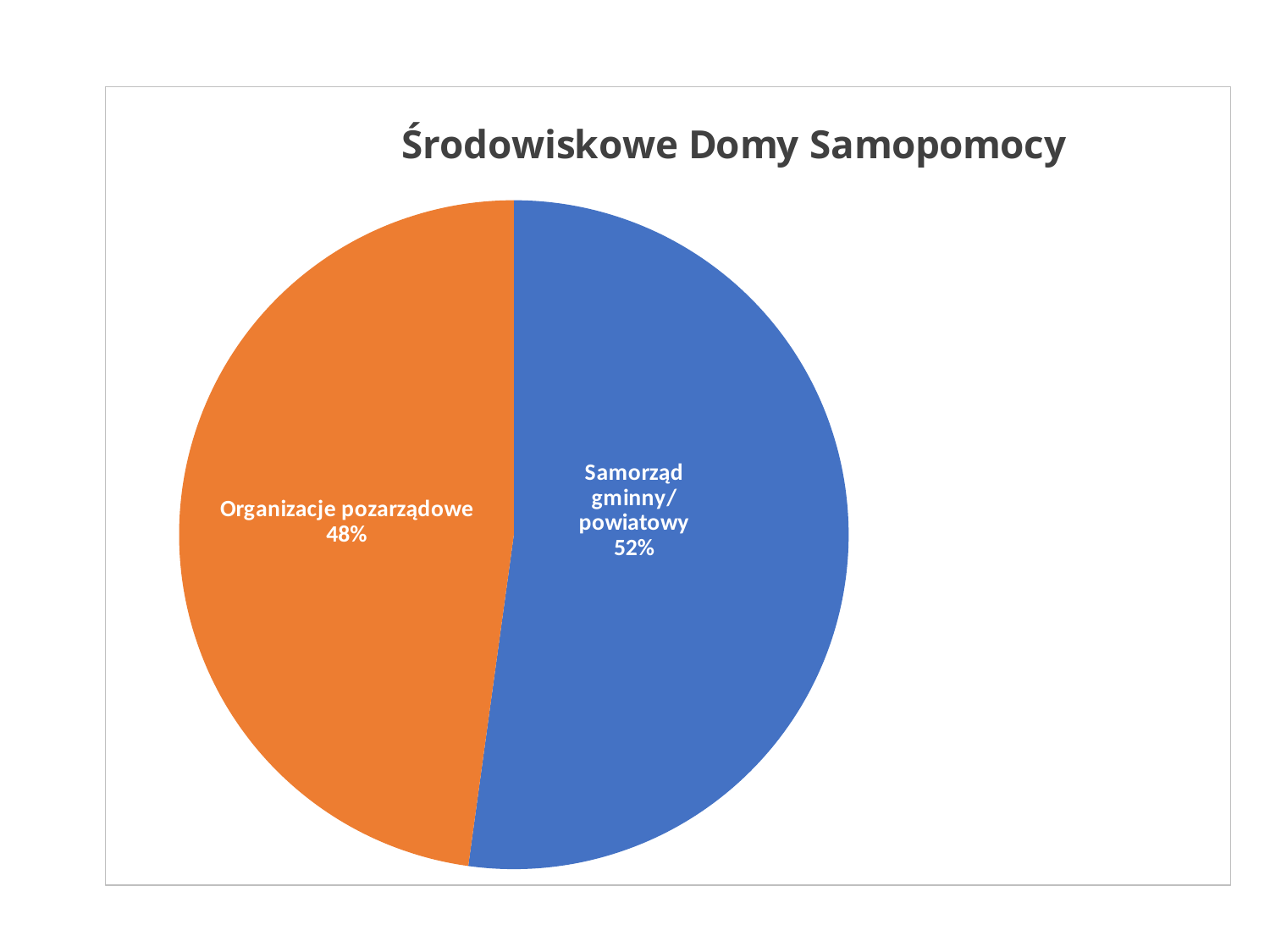
Is the share for Organizacje pozarządowe greater or less than 50%? less Which slice is the largest? Samorząd gminny/powiatowy Which slice is the smallest? Organizacje pozarządowe What is the title of the chart? Środowiskowe Domy Samopomocy What is the difference in percentage points between Samorząd gminny/powiatowy and Organizacje pozarządowe? 4 What kind of chart is shown on the slide? pie chart What colour is the slice for Organizacje pozarządowe? orange How many slices does the pie chart have? 2 Is the share for Samorząd gminny/powiatowy greater or less than 50%? greater Which is larger, the share for Organizacje pozarządowe or the share for Samorząd gminny/powiatowy? Samorząd gminny/powiatowy What share of the pie does Organizacje pozarządowe have? 48% What share of the pie does Samorząd gminny/powiatowy have? 52%